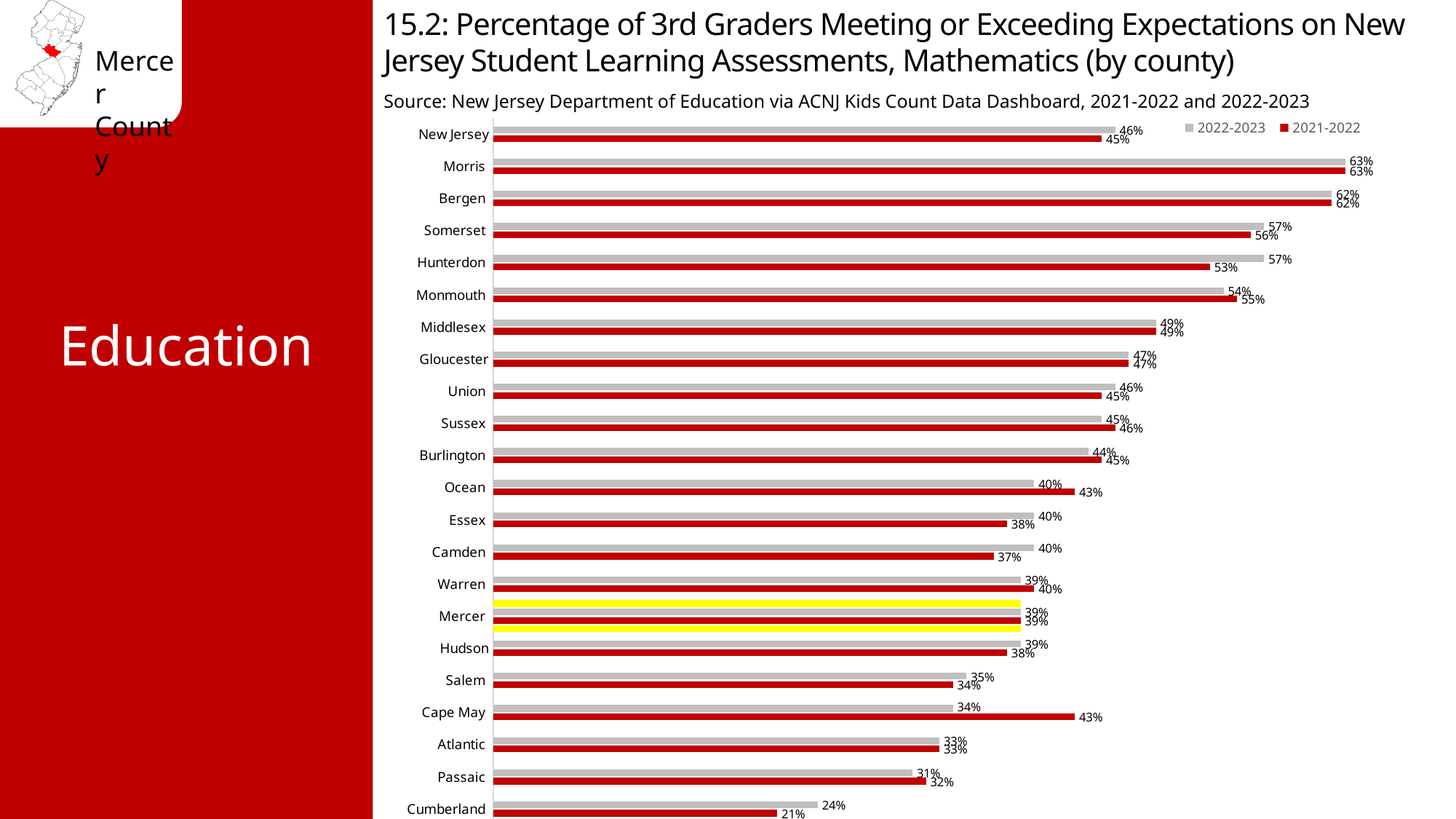
What is the difference between the 2022-2023 values for Morris and Cumberland? 39% Which series is shown in red in the legend? 2021-2022 How many series does the legend list? 2 What kind of chart is shown on the slide? Bar chart How many counties or regions are listed on the chart? 22 What is the 2022-2023 value for Mercer? 39% Which county has the highest 2022-2023 value? Morris What is the 2022-2023 value for Hunterdon? 57% Which is larger for Ocean: the 2022-2023 value or the 2021-2022 value? 2021-2022 What is the 2021-2022 value for Cape May? 43% What is the difference between the 2022-2023 and 2021-2022 values for Cape May? 9% Which county has the lowest 2021-2022 value? Cumberland